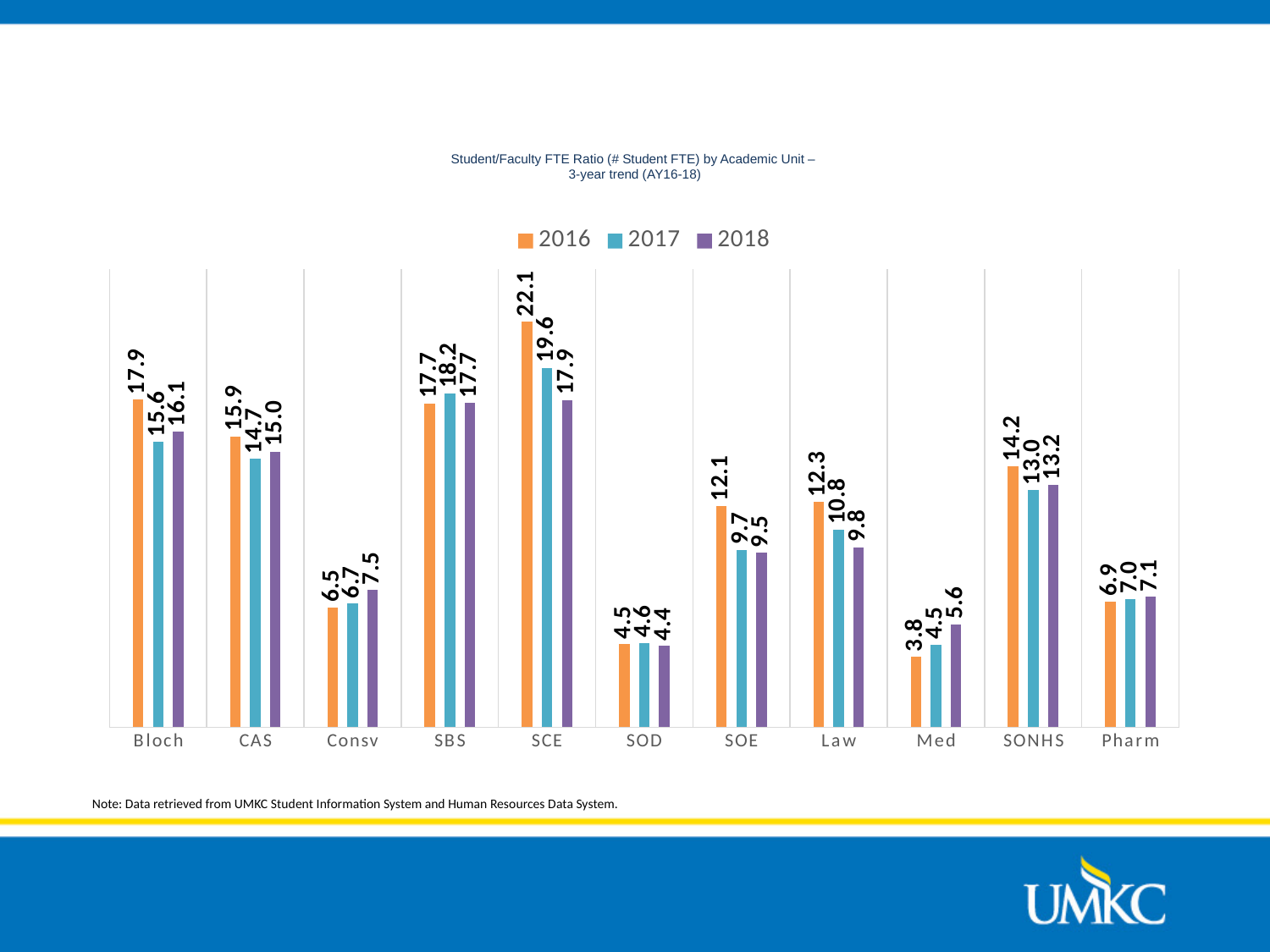
What is the 2016 Student/Faculty FTE ratio for SCE? 22.1 How many series does the legend list? 3 Which is larger, the 2017 ratio for Bloch or the 2017 ratio for CAS? Bloch What kind of chart is shown on the slide? Bar chart Which academic unit has the lowest 2018 Student/Faculty FTE ratio? SOD What is the 2017 Student/Faculty FTE ratio for SONHS? 13.0 Which academic unit has the highest 2016 Student/Faculty FTE ratio? SCE Which year is represented by the orange bars in the legend? 2016 Did the Student/Faculty FTE ratio for Consv rise or fall from 2016 to 2018? Rise What is the difference between the 2016 and 2018 Student/Faculty FTE ratios for SCE? 4.2 What is the 2018 Student/Faculty FTE ratio for Med? 5.6 How many academic units are shown on the x axis? 11